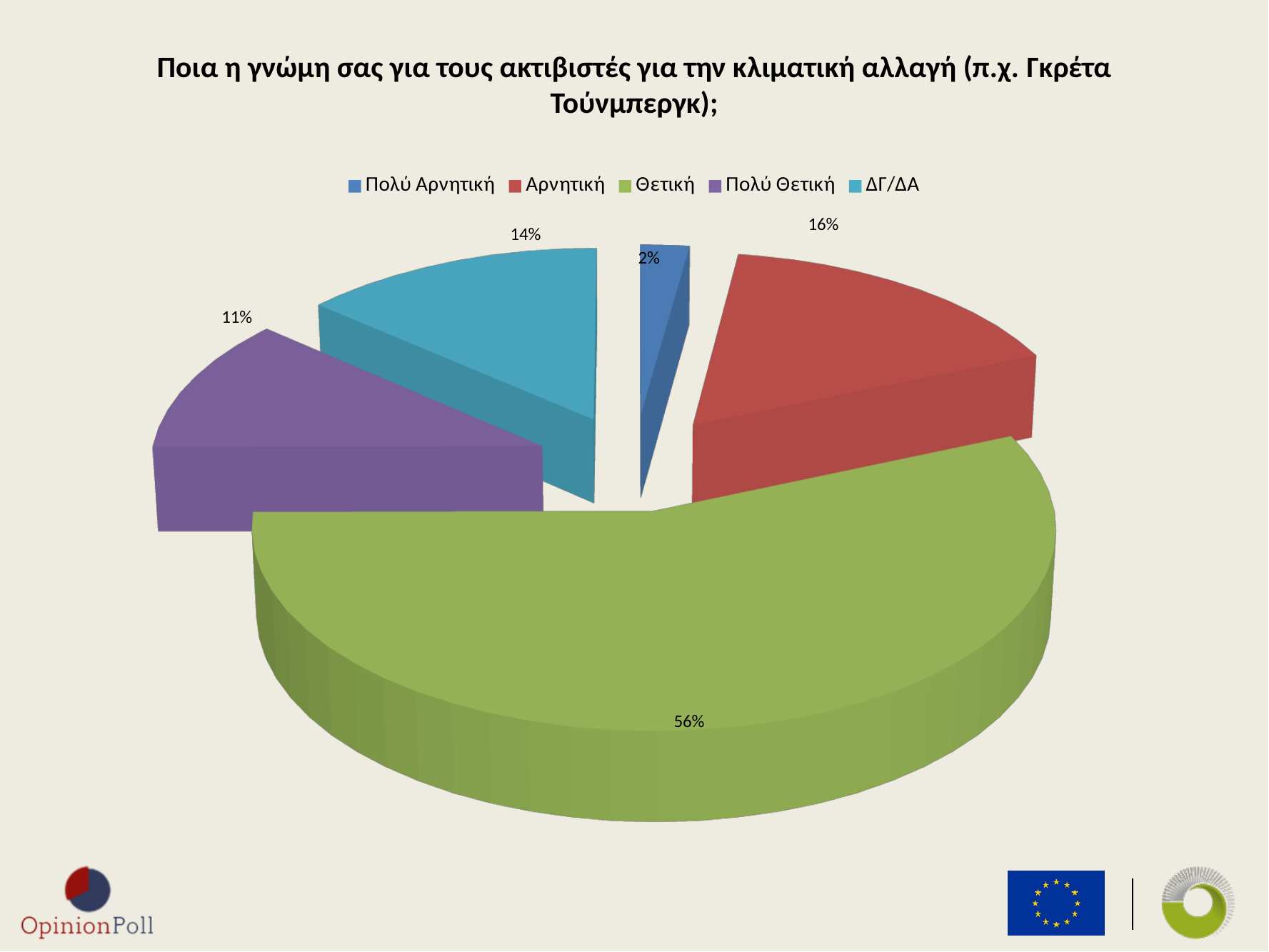
Which is larger, ΔΓ/ΔΑ or Πολύ Θετική? ΔΓ/ΔΑ What is the difference between Αρνητική and Πολύ Θετική? 5% Which category has the largest slice? Θετική What is the value for Αρνητική? 16% What is the value for Πολύ Θετική? 11% How many categories does the pie chart show? 5 What is the value for Πολύ Αρνητική? 2% What kind of chart is shown on the slide? Pie chart What share of the pie does Θετική have? 56% What is the value for ΔΓ/ΔΑ? 14% What colour is the Θετική slice? Green Which category has the smallest slice? Πολύ Αρνητική